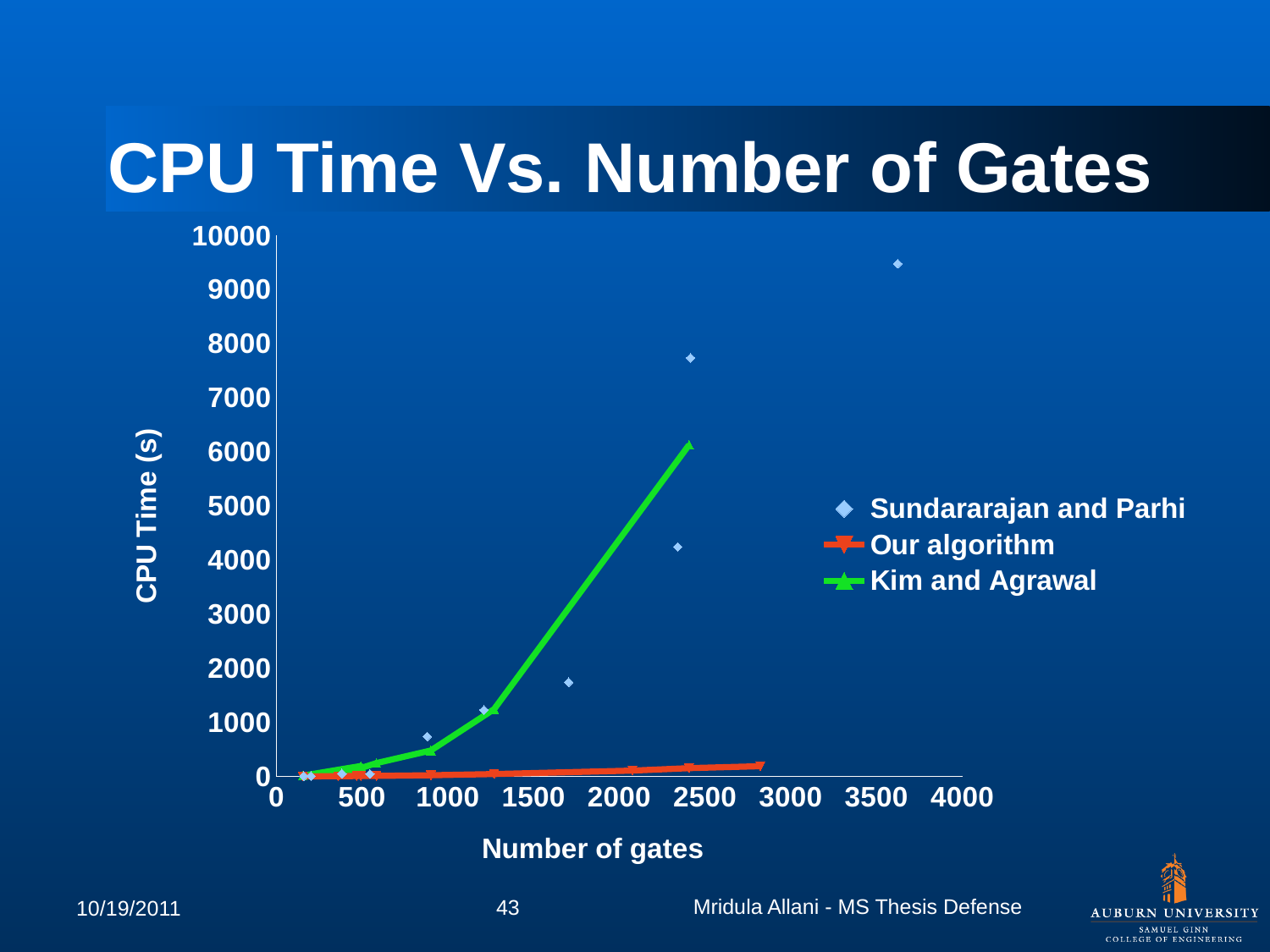
Is the highest CPU time for Kim and Agrawal greater or less than 5000? greater Does the CPU time for Kim and Agrawal rise or fall as the number of gates increases? rise How many series does the legend list? 3 Is the highest CPU time for Sundararajan and Parhi greater or less than 9000? greater Is the highest CPU time for Our algorithm greater or less than 1000? less What kind of chart is shown on the slide? line chart Which series stays lowest in CPU time across the number of gates? Our algorithm What is the maximum value shown on the CPU Time axis? 10000 What is the title of the chart? CPU Time Vs. Number of Gates At around 2500 gates, which series has the higher CPU time, Kim and Agrawal or Our algorithm? Kim and Agrawal What is the label of the vertical axis? CPU Time (s) Which series reaches the highest CPU time on the chart? Sundararajan and Parhi